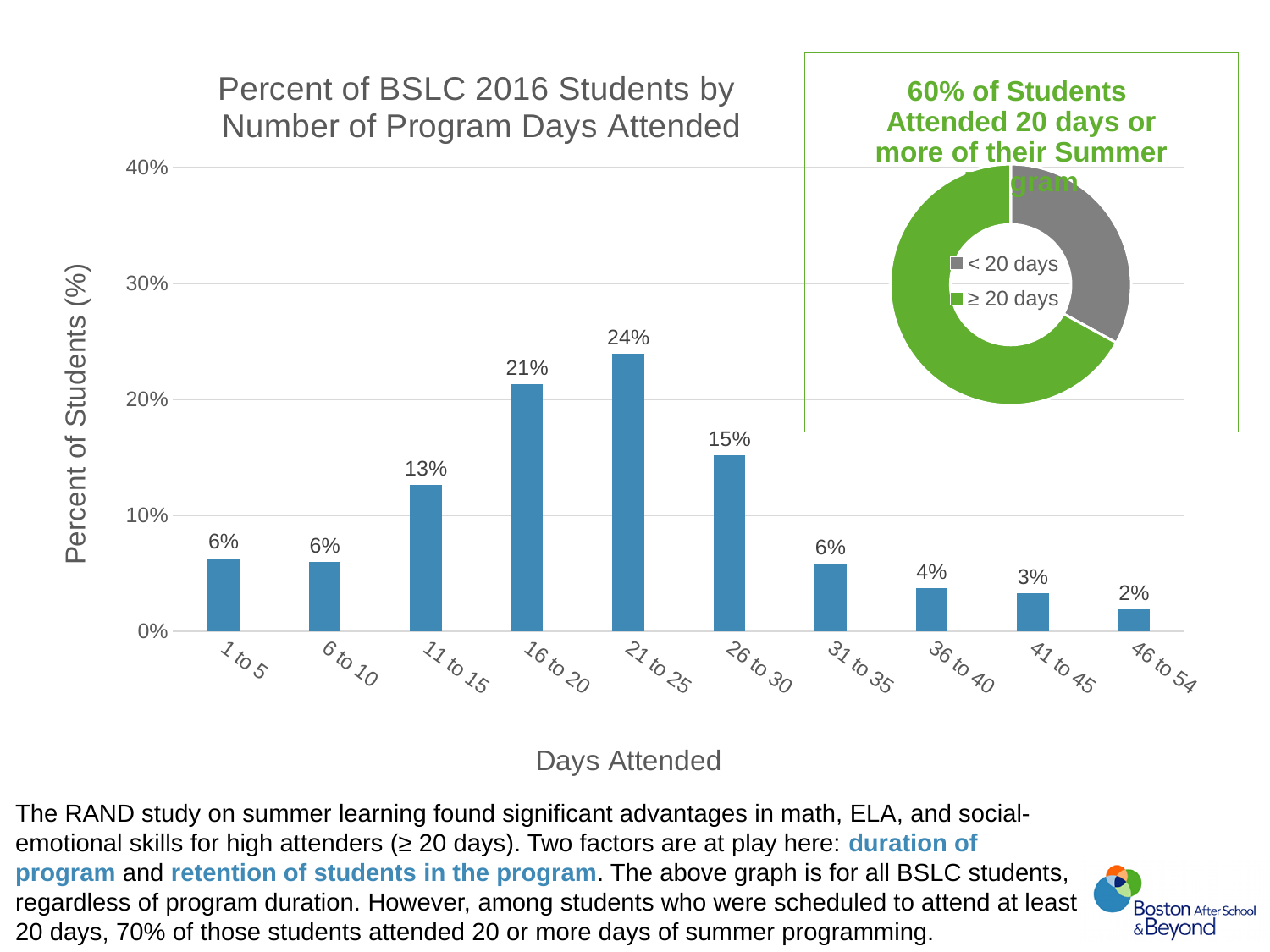
How many days-attended categories are shown on the x axis of the bar chart? 10 In the bar chart, which days-attended category has the lowest percent of students? 46 to 54 In the bar chart, which days-attended category has the highest percent of students? 21 to 25 In the bar chart, what is the difference in percent of students between the 21 to 25 and 16 to 20 categories? 3% What type of chart is the large chart on the left of the slide? bar chart In the bar chart 'Percent of BSLC 2016 Students by Number of Program Days Attended', what percent of students attended 21 to 25 days? 24% In the bar chart, is the value for 16 to 20 days greater or less than 20%? greater In the donut chart in the top right, how many entries does the legend list? 2 In the bar chart, which category has a larger percent of students: 26 to 30 or 31 to 35? 26 to 30 In the bar chart, what percent of students attended 46 to 54 days? 2% In the bar chart, what percent of students attended 11 to 15 days? 13%